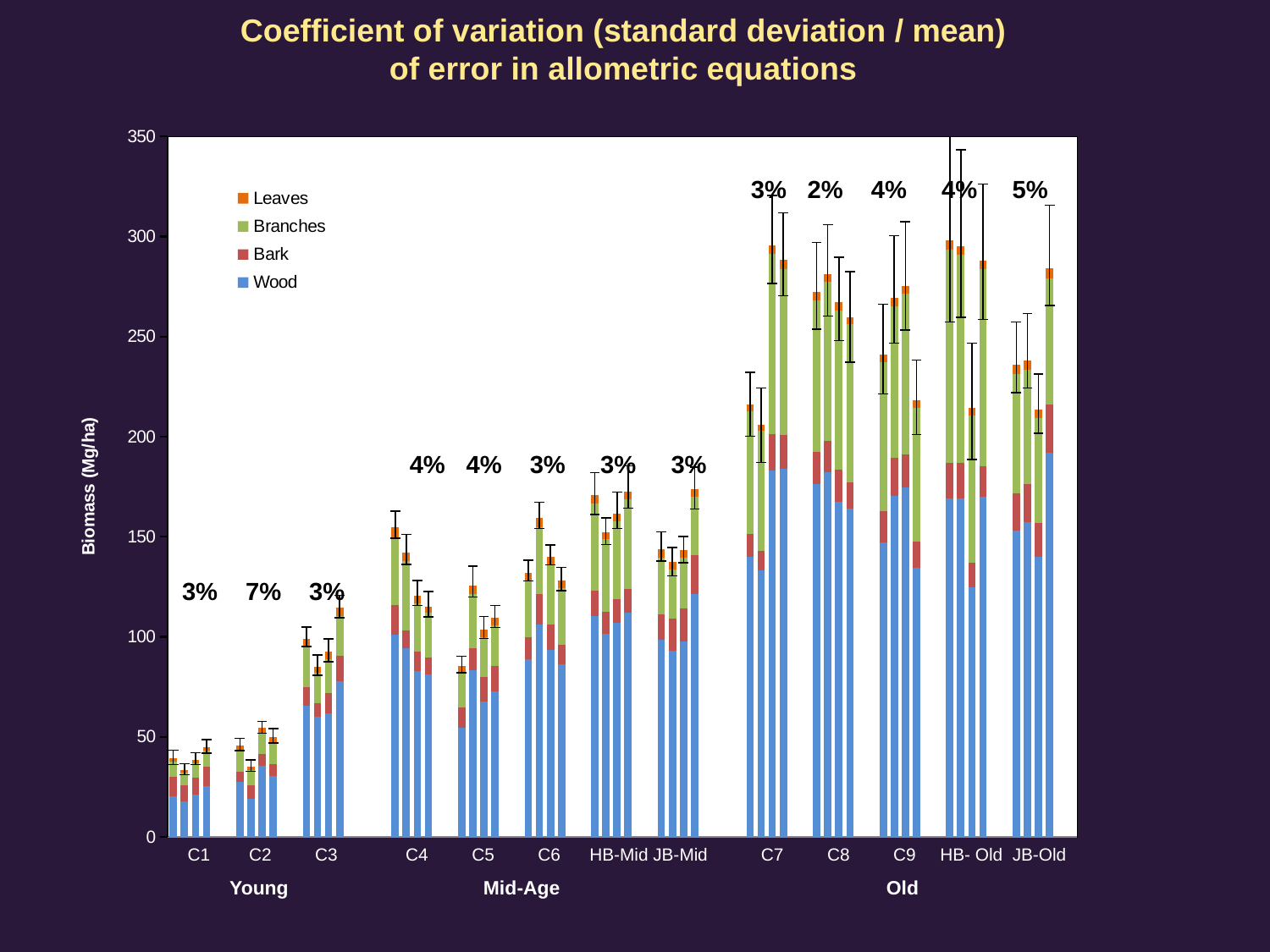
Which site group has the highest coefficient of variation percentage printed above it? C2 What coefficient of variation percentage is printed above the C2 group? 7% How many site categories are labelled along the x axis? 13 What is the title of the y axis? Biomass (Mg/ha) What kind of chart is shown on the slide? bar chart What coefficient of variation percentage is printed above the C8 group? 2% Is the biomass of the tallest bar in the C1 group greater or less than 50? less What coefficient of variation percentage is printed above the JB-Old group? 5% Which site group has the lowest coefficient of variation percentage printed above it? C8 How many series does the legend list? 4 Is the biomass of the tallest bar in the C7 group greater or less than 250? greater Which group has taller biomass bars, C1 or C3? C3